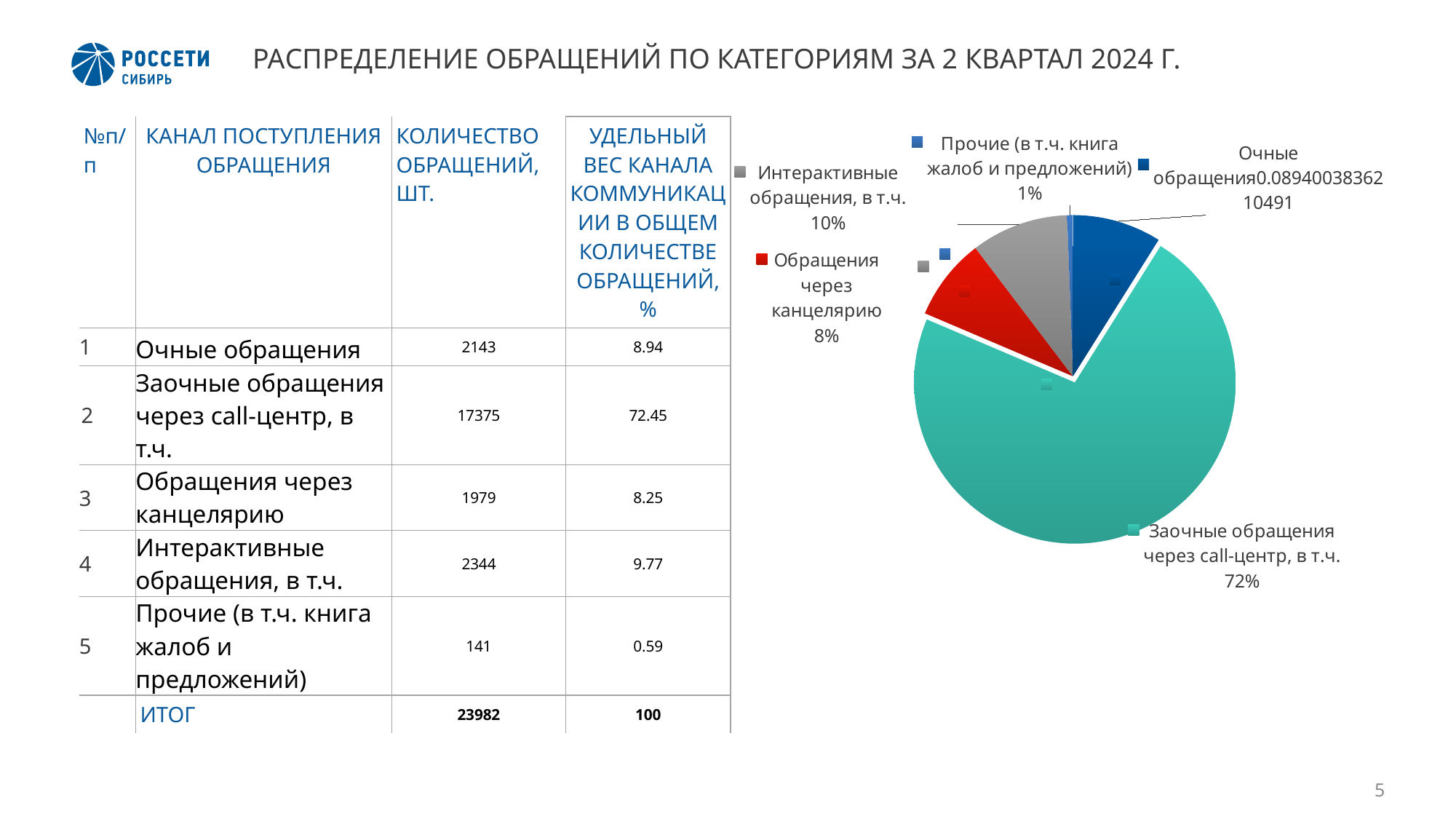
Which category has the smallest slice in the pie chart? Прочие (в т.ч. книга жалоб и предложений) Which category has the largest slice in the pie chart? Заочные обращения через call-центр, в т.ч. Which slice is larger in the pie chart: Интерактивные обращения or Обращения через канцелярию? Интерактивные обращения What is the title of the slide containing the pie chart? РАСПРЕДЕЛЕНИЕ ОБРАЩЕНИЙ ПО КАТЕГОРИЯМ ЗА 2 КВАРТАЛ 2024 Г. What share of the pie does Заочные обращения через call-центр take? 72% What kind of chart is shown on the slide? pie chart How many slices does the pie chart have? 5 What percentage is shown for Обращения через канцелярию in the pie chart? 8% What percentage is shown for Прочие (в т.ч. книга жалоб и предложений) in the pie chart? 1% What percentage is shown for Интерактивные обращения in the pie chart? 10% What is the difference in percentage points between the Заочные обращения через call-центр slice and the Интерактивные обращения slice? 62 What percentage is shown for Заочные обращения через call-центр in the pie chart? 72%